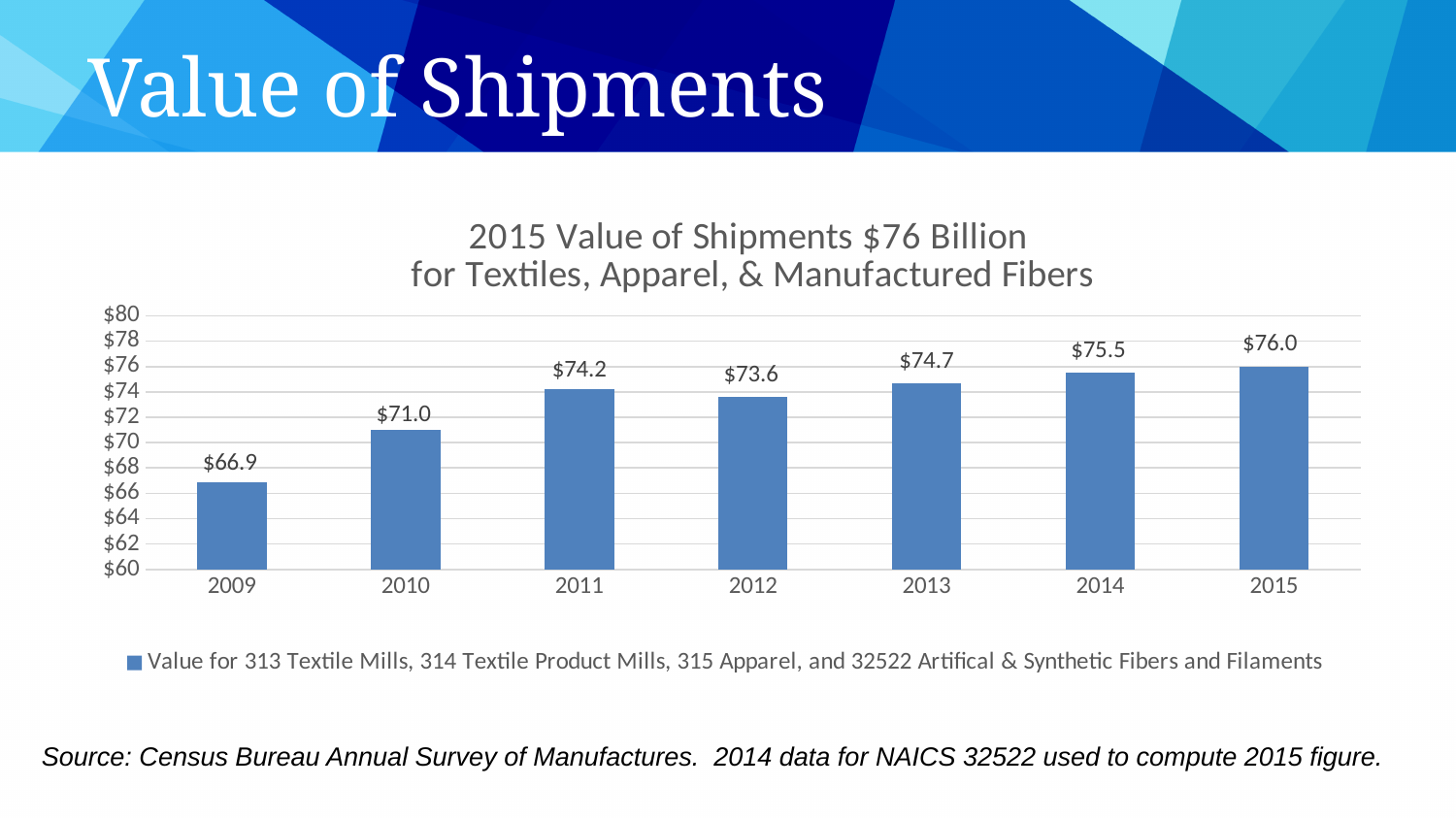
Is the value for 2010 greater or less than $72? less What is the value of shipments for 2014? $75.5 Which year has the lowest value of shipments? 2009 What is the title of the chart? 2015 Value of Shipments $76 Billion for Textiles, Apparel, & Manufactured Fibers Which year has a larger value of shipments, 2010 or 2013? 2013 What is the value of shipments for 2012? $73.6 How many years are shown on the chart? 7 What is the difference between the 2015 value and the 2009 value? $9.1 Which year has the highest value of shipments? 2015 What is the difference between the 2011 value and the 2012 value? $0.6 What kind of chart is shown on the slide? Bar chart What is the value of shipments for 2009? $66.9